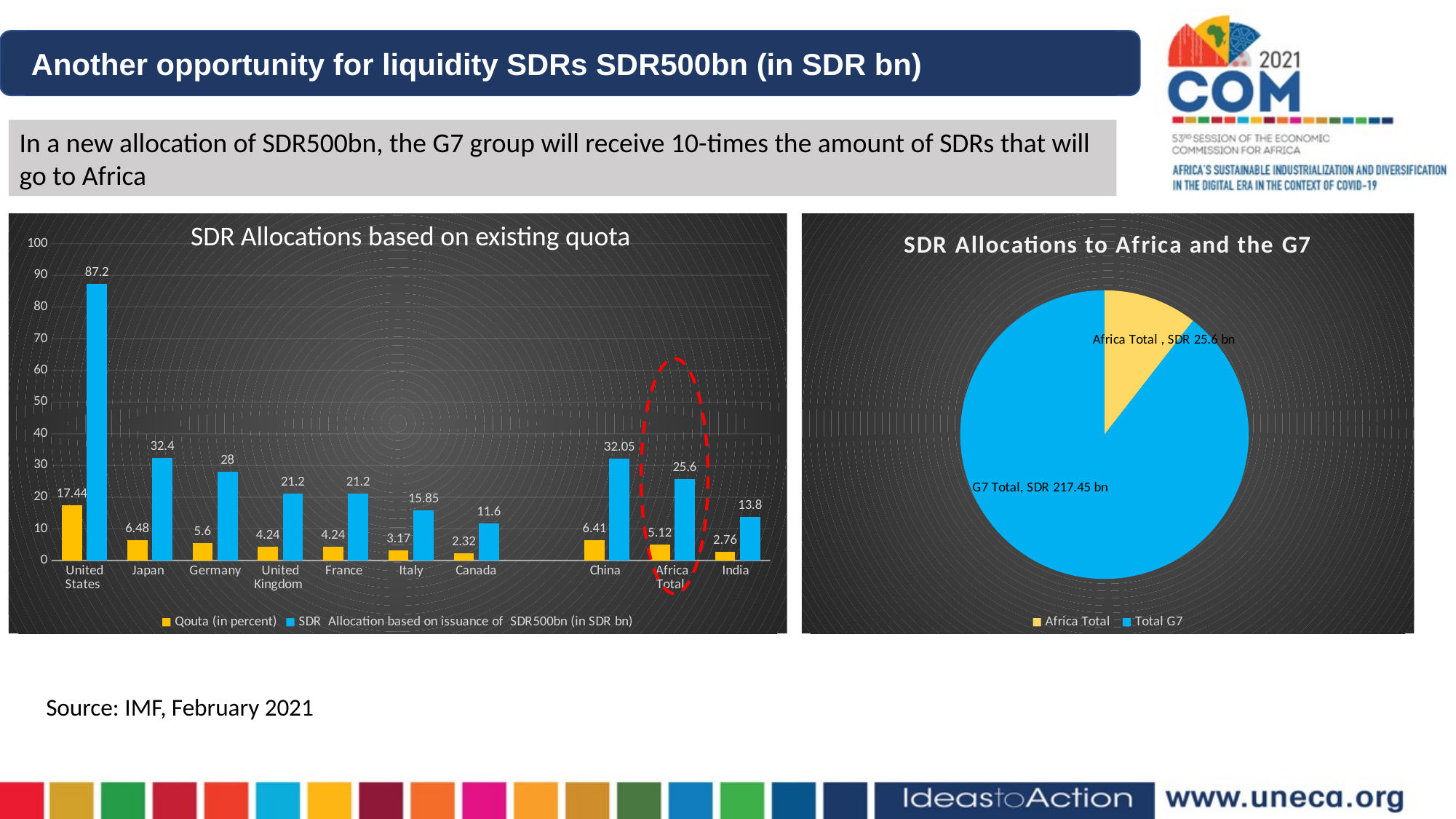
How many series does the legend of the 'SDR Allocations based on existing quota' chart list? 2 In the 'SDR Allocations based on existing quota' chart, what is the SDR allocation for the United States? 87.2 In the 'SDR Allocations based on existing quota' chart, which category has the highest SDR allocation? United States In the 'SDR Allocations to Africa and the G7' pie chart, which slice is larger, Africa Total or Total G7? Total G7 In the 'SDR Allocations based on existing quota' chart, which category has the lowest quota (in percent)? Canada In the 'SDR Allocations based on existing quota' chart, what is the quota (in percent) for Japan? 6.48 What kind of chart is 'SDR Allocations to Africa and the G7'? Pie chart How many categories are shown on the x axis of the 'SDR Allocations based on existing quota' chart? 10 In the 'SDR Allocations to Africa and the G7' pie chart, what is the value for G7 Total? SDR 217.45 bn In the 'SDR Allocations based on existing quota' chart, what is the SDR allocation for Africa Total? 25.6 In the 'SDR Allocations based on existing quota' chart, which has a larger SDR allocation, Germany or Italy? Germany In the 'SDR Allocations based on existing quota' chart, what is the difference between the SDR allocations for China and India? 18.25